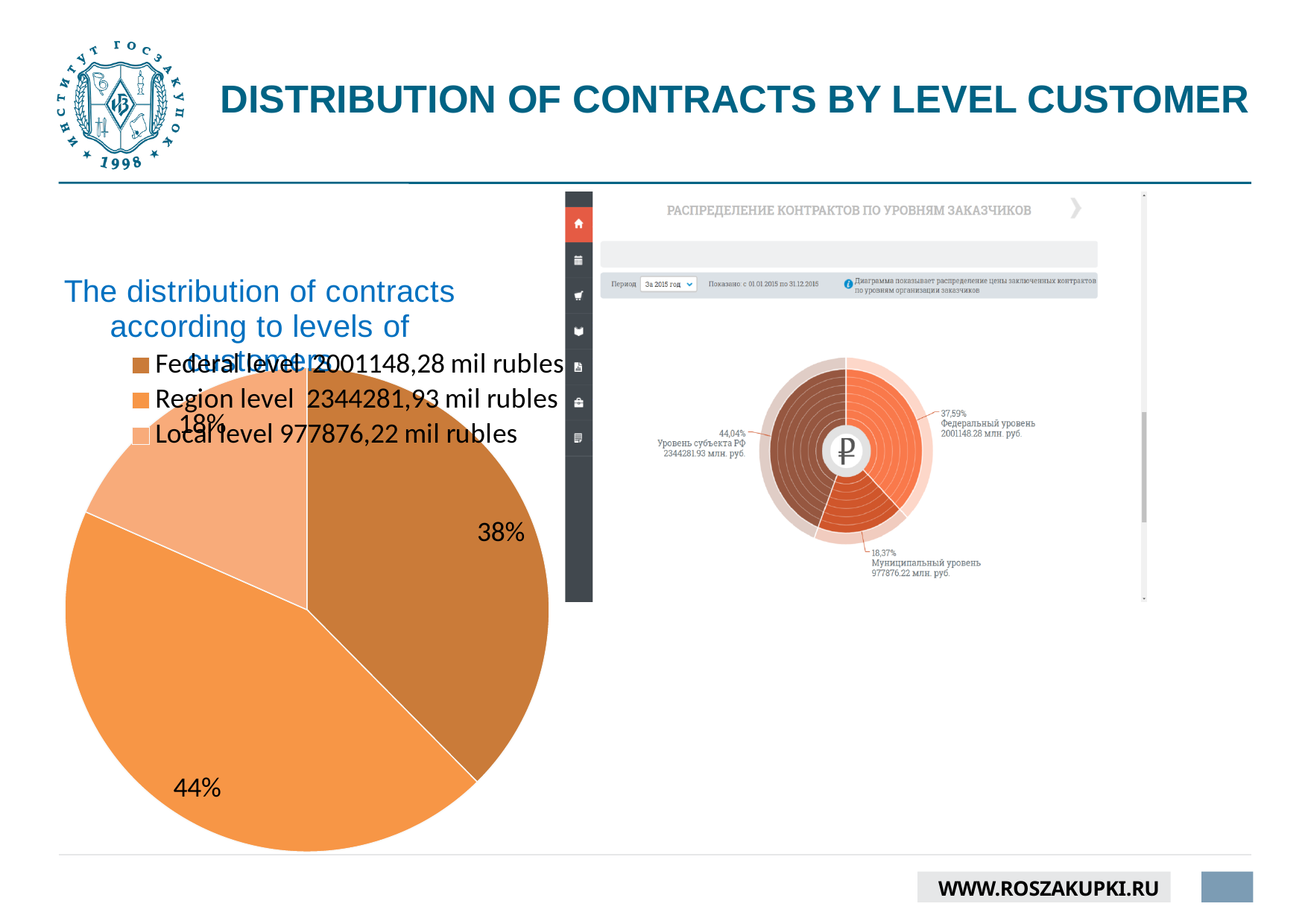
What kind of chart is shown on the left side of the slide? pie chart How many entries does the legend of the pie chart on the left list? 3 In the pie chart on the left, what percentage share is shown for Region level? 44% In the pie chart on the left, what percentage share is shown for Federal level? 38% In the pie chart on the left, which level has the smallest share? Local level How many slices does the pie chart on the left have? 3 According to the legend of the pie chart on the left, what value in mil rubles is given for Federal level? 2001148,28 mil rubles In the pie chart on the left, what percentage share is shown for Local level? 18% In the pie chart on the left, what is the difference in percentage points between the Region level share and the Federal level share? 6% In the pie chart on the left, which is larger: the Federal level share or the Local level share? Federal level According to the legend of the pie chart on the left, what value in mil rubles is given for Local level? 977876,22 mil rubles In the pie chart on the left, which level has the largest share? Region level